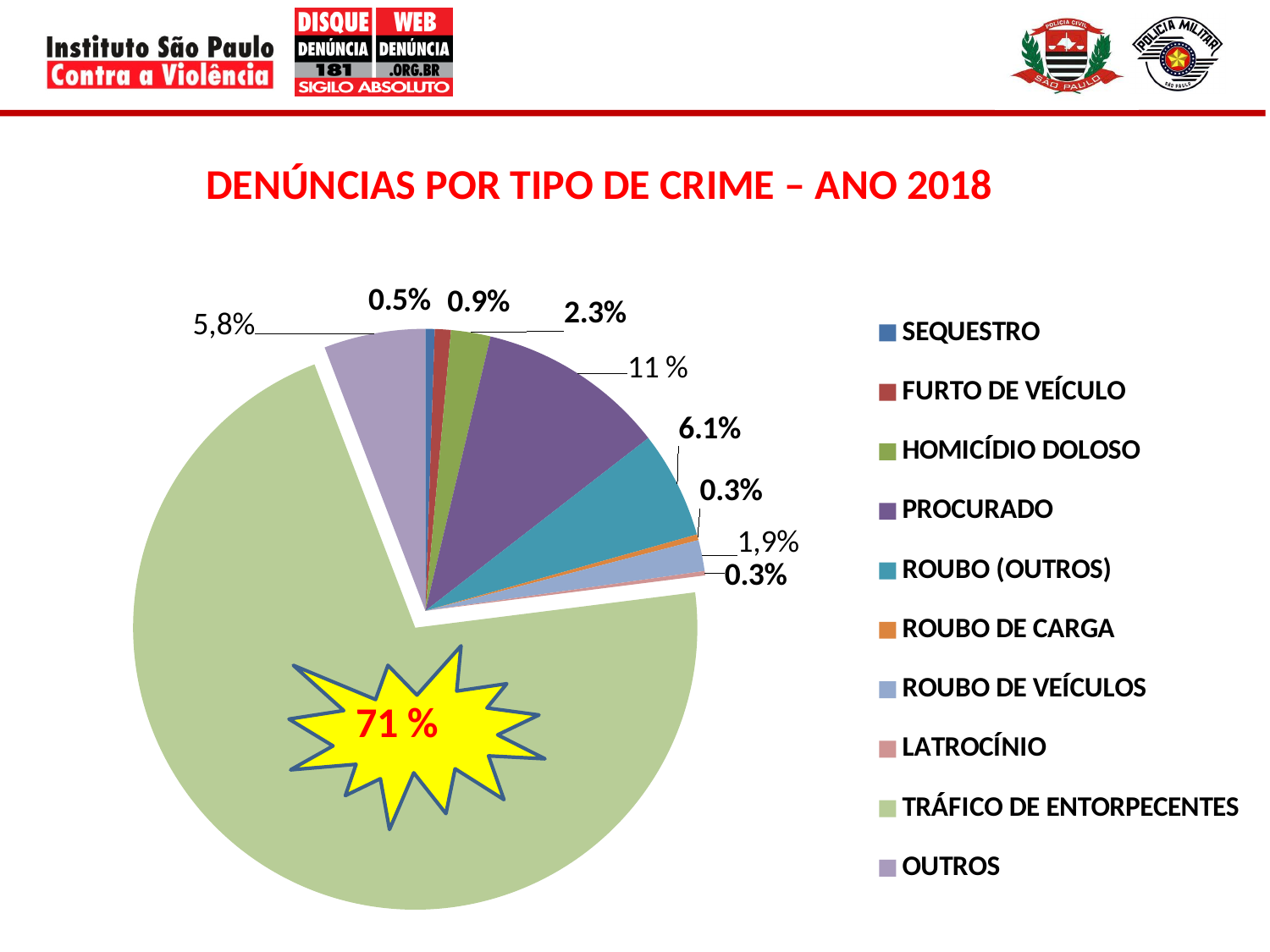
What is the value shown for HOMICÍDIO DOLOSO? 2.3% Which category has the largest slice of the pie? TRÁFICO DE ENTORPECENTES What is the difference between the values for ROUBO (OUTROS) and HOMICÍDIO DOLOSO? 3.8% Which is larger, the slice for PROCURADO or the slice for ROUBO (OUTROS)? PROCURADO What is the value shown for ROUBO DE VEÍCULOS? 1,9% What is the value shown for OUTROS? 5,8% What share of the pie does TRÁFICO DE ENTORPECENTES represent? 71 % What is the value shown for ROUBO (OUTROS)? 6.1% What share of the pie does PROCURADO represent? 11 % How many categories does the legend of the pie chart list? 10 What kind of chart is shown on the slide? pie chart What is the title of the chart? DENÚNCIAS POR TIPO DE CRIME – ANO 2018